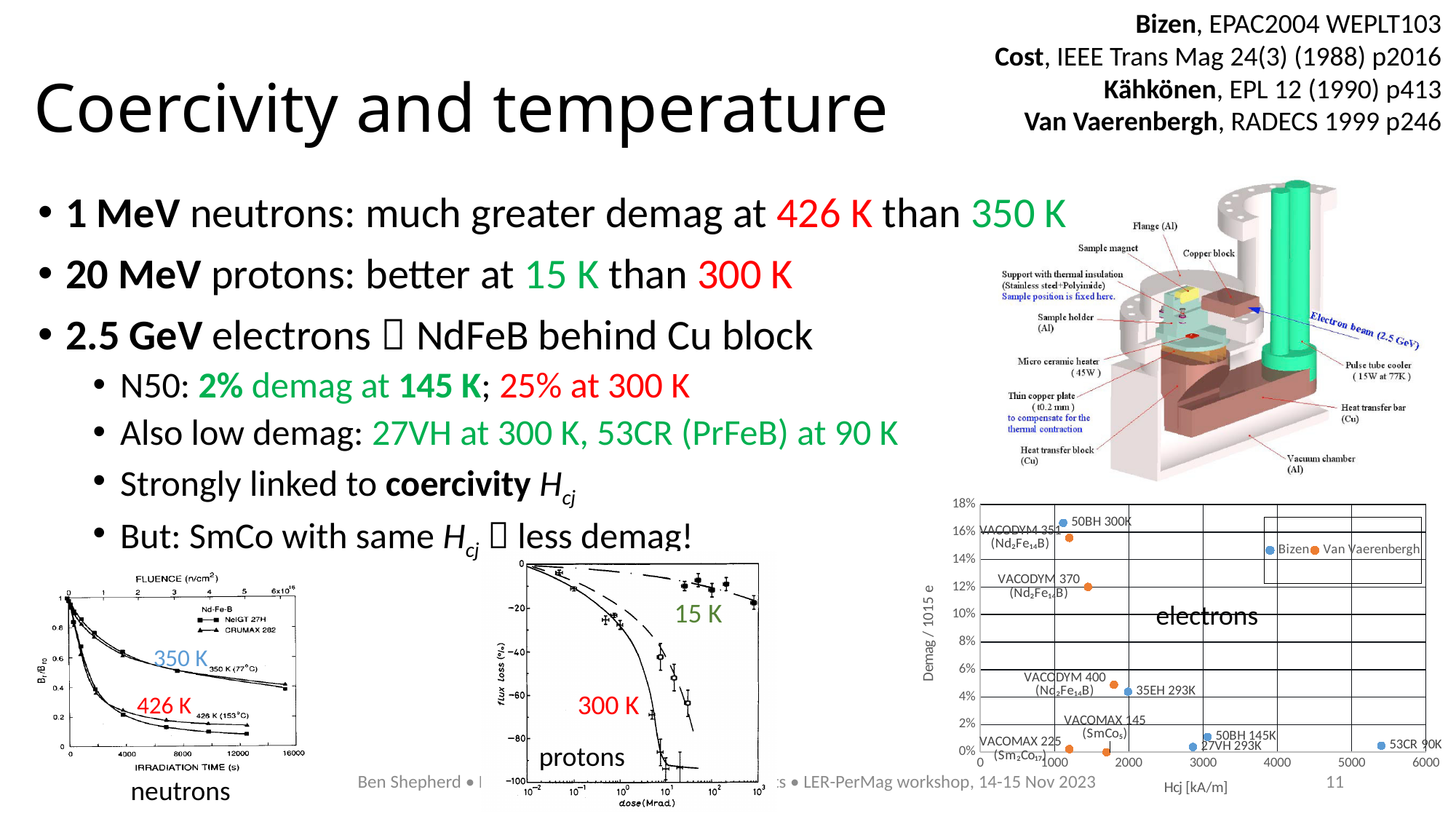
In the electrons chart (bottom right), which has the larger demag value, VACODYM 370 or 35EH 293K? VACODYM 370 In the electrons chart (bottom right), what is the label of the x axis? Hcj [kA/m] In the neutrons chart (bottom left), do the Br/Br0 values rise or fall as irradiation time increases? fall In the electrons chart (bottom right), is the demag value for 53CR 90K greater or less than 2%? less In the protons chart (bottom middle), which temperature curve shows the greater flux loss at 10 Mrad, 15 K or 300 K? 300 K In the electrons chart (bottom right), what are the two legend entries? Bizen and Van Vaerenbergh In the electrons chart (bottom right), is the demag value for 50BH 300K greater or less than 14%? greater In the electrons chart (bottom right), is the demag value for VACODYM 400 greater or less than 8%? less In the electrons chart (bottom right), which point has the largest Hcj value? 53CR 90K In the electrons chart (bottom right), how many series does the legend list? 2 In the electrons chart (bottom right), which point has the highest demag value? 50BH 300K In the neutrons chart (bottom left), which temperature curve shows the lower Br/Br0 at 12000 s, 350 K or 426 K? 426 K